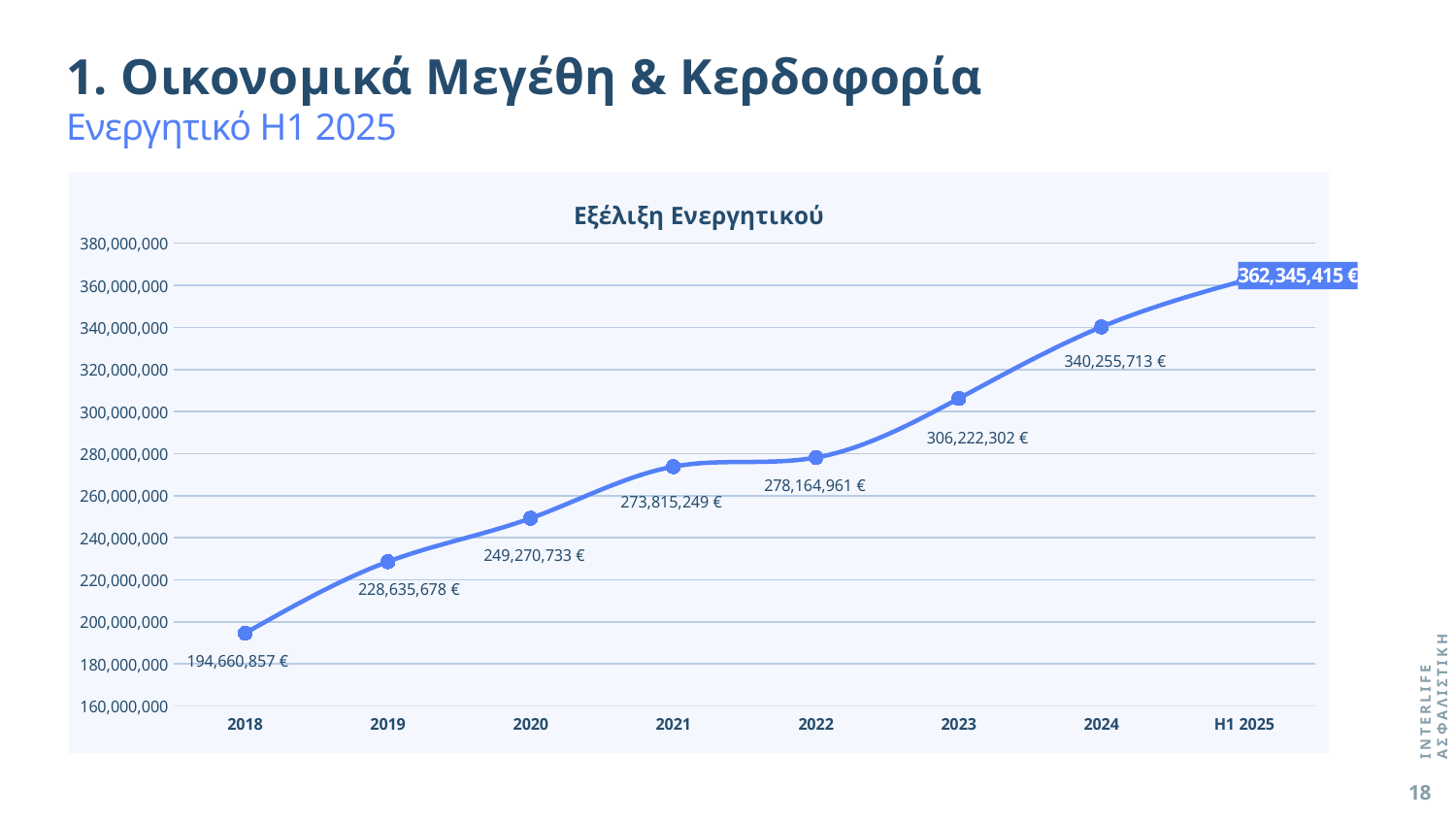
What kind of chart is shown? Line chart What is the value for 2021? 273,815,249 € What is the title of the chart? Εξέλιξη Ενεργητικού Which period has the highest value? H1 2025 Which period has the lowest value? 2018 Which is larger, the value for 2020 or the value for 2019? 2020 How many data points are plotted on the chart? 8 What is the value for H1 2025? 362,345,415 € What is the difference between the values for 2022 and 2021? 4,349,712 € What is the value for 2023? 306,222,302 € What is the value for 2018? 194,660,857 € What is the difference between the values for 2024 and 2023? 34,033,411 €